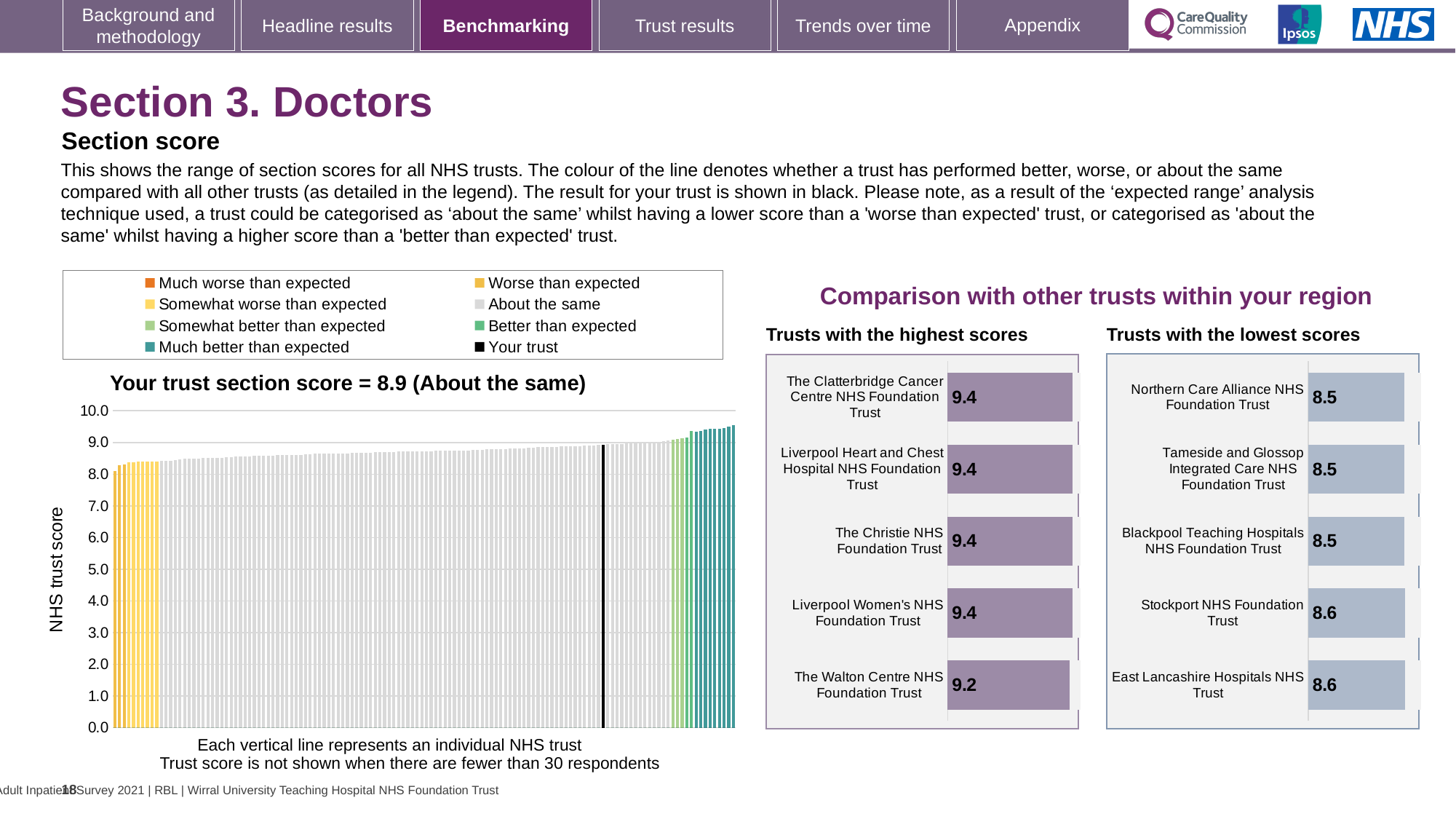
In the 'Your trust section score' chart, what is the section score for your trust? 8.9 In the 'Trusts with the highest scores' chart, which trust has the lowest score? The Walton Centre NHS Foundation Trust In the 'Your trust section score' chart, what kind of chart is shown? bar chart In the 'Your trust section score' chart, what is the label on the vertical axis? NHS trust score In the 'Trusts with the highest scores' chart, what is the difference between the score for The Christie NHS Foundation Trust and The Walton Centre NHS Foundation Trust? 0.2 In the 'Trusts with the lowest scores' chart, which is larger, the score for Stockport NHS Foundation Trust or Blackpool Teaching Hospitals NHS Foundation Trust? Stockport NHS Foundation Trust In the 'Trusts with the highest scores' chart, what is the score for The Walton Centre NHS Foundation Trust? 9.2 In the 'Your trust section score' chart, do the trust scores rise or fall from left to right along the x axis? rise In the 'Trusts with the highest scores' chart, how many trusts are shown? 5 In the 'Trusts with the lowest scores' chart, what is the difference between the score for East Lancashire Hospitals NHS Trust and Northern Care Alliance NHS Foundation Trust? 0.1 How many entries does the legend above the 'Your trust section score' chart list? 8 In the 'Trusts with the lowest scores' chart, what is the score for Stockport NHS Foundation Trust? 8.6